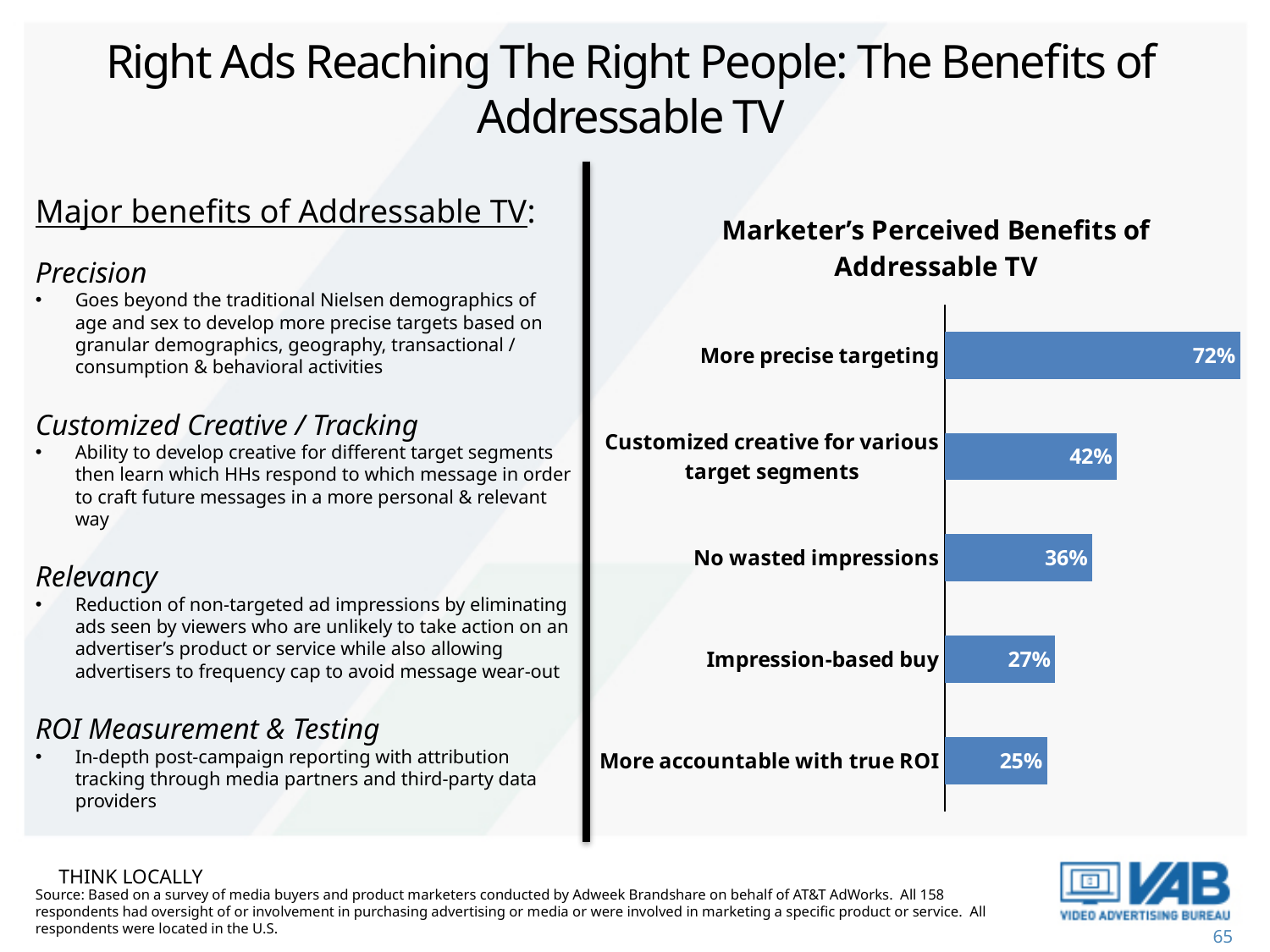
Which perceived benefit has the highest percentage? More precise targeting Which perceived benefit has the lowest percentage? More accountable with true ROI What is the value for 'More accountable with true ROI'? 25% What is the value for 'No wasted impressions'? 36% What percentage of marketers cited 'More precise targeting' as a perceived benefit of Addressable TV? 72% What is the difference in percentage points between 'More precise targeting' and 'Customized creative for various target segments'? 30 What is the title of the chart on the slide? Marketer's Perceived Benefits of Addressable TV Which is larger: the value for 'No wasted impressions' or the value for 'Impression-based buy'? No wasted impressions How many perceived benefits are shown in the chart? 5 What type of chart is used to show the marketer's perceived benefits? Bar chart What is the value for 'Impression-based buy'? 27% What is the value for 'Customized creative for various target segments'? 42%